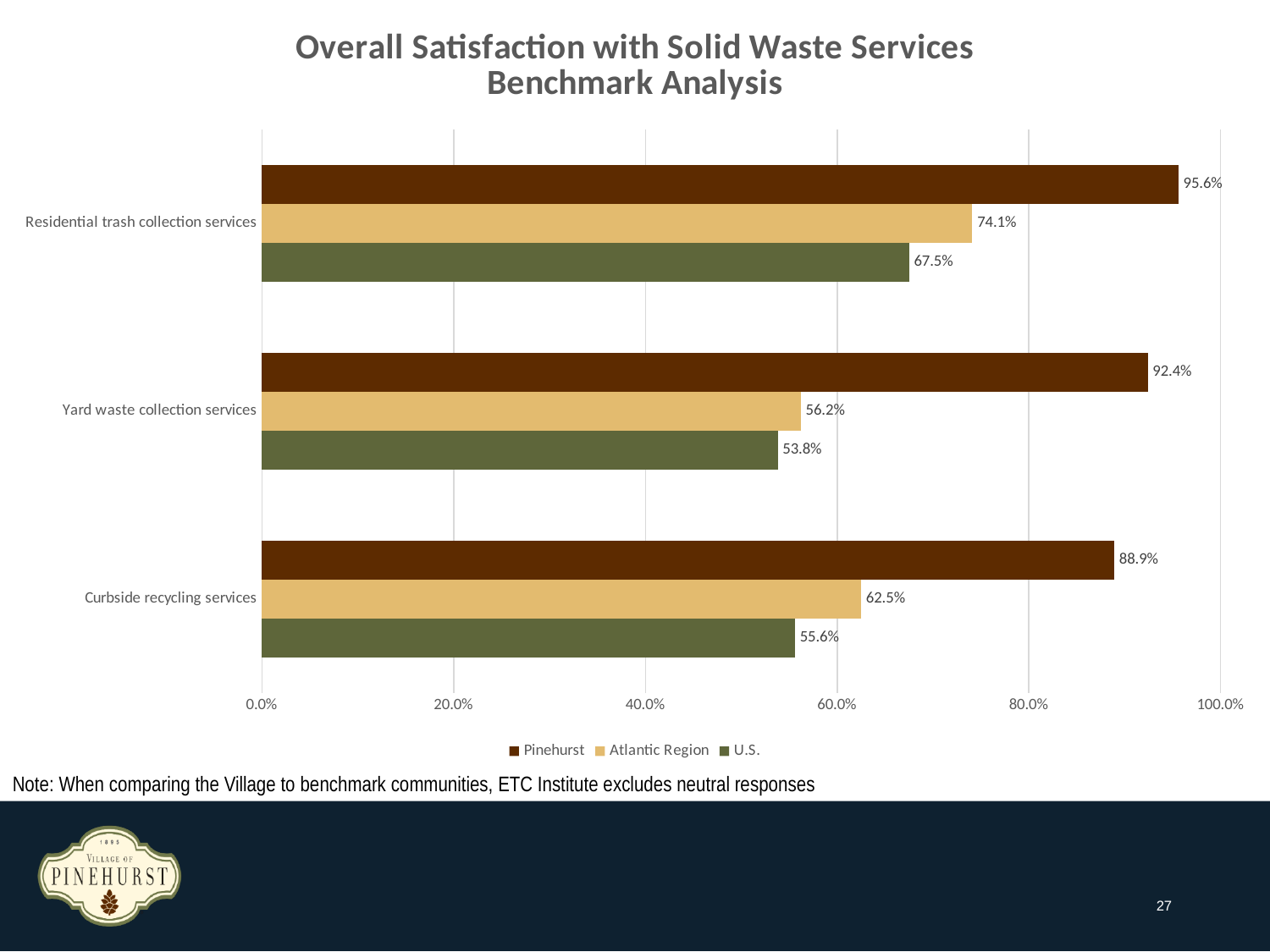
Which category has the lowest Atlantic Region value? Yard waste collection services What is the Atlantic Region value for Curbside recycling services? 62.5% What is the U.S. value for Yard waste collection services? 53.8% What is the difference between the Pinehurst and U.S. values for Yard waste collection services? 38.6% Which category has the highest Pinehurst value? Residential trash collection services What is the title of the chart? Overall Satisfaction with Solid Waste Services Benchmark Analysis How many series does the legend list? 3 What kind of chart is shown on the slide? bar chart Is the U.S. value for Residential trash collection services greater or less than 60.0%? greater How many categories are shown on the chart? 3 What is the Pinehurst value for Residential trash collection services? 95.6% Which is larger for Curbside recycling services: the Atlantic Region value or the U.S. value? Atlantic Region